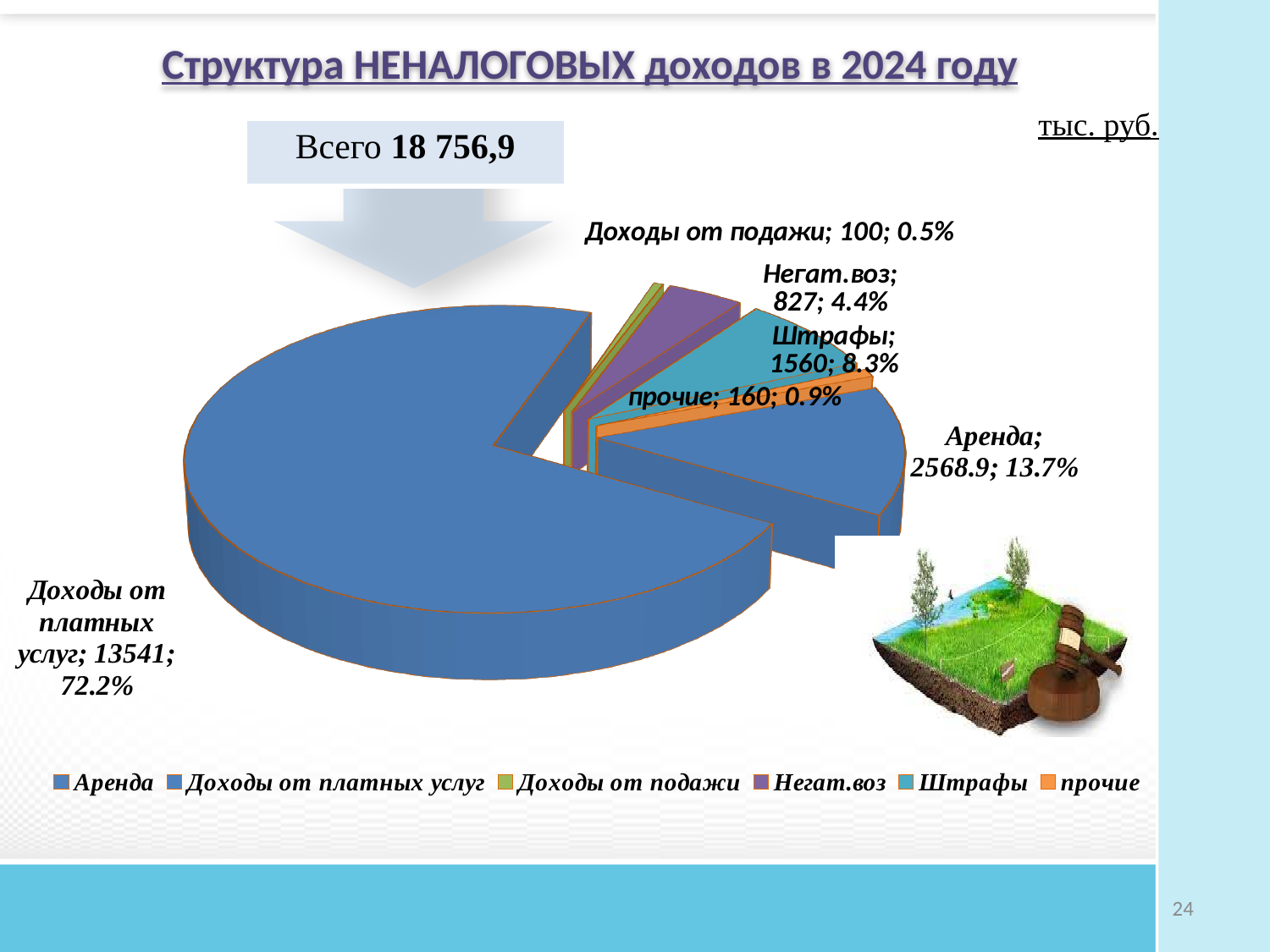
How many entries does the legend list? 6 What share of the pie does прочие represent? 0.9% Which is larger, the value for Аренда or the value for Штрафы? Аренда What kind of chart is shown on the slide? pie chart Which category has the smallest slice of the pie? Доходы от подажи What is the value for Штрафы? 1560 What share of the pie does Доходы от платных услуг represent? 72.2% What is the value for Аренда? 2568.9 What is the difference between the values for Штрафы and Негат.воз? 733 What is the value for Доходы от подажи? 100 What is the value for Негат.воз? 827 Which category has the largest slice of the pie? Доходы от платных услуг